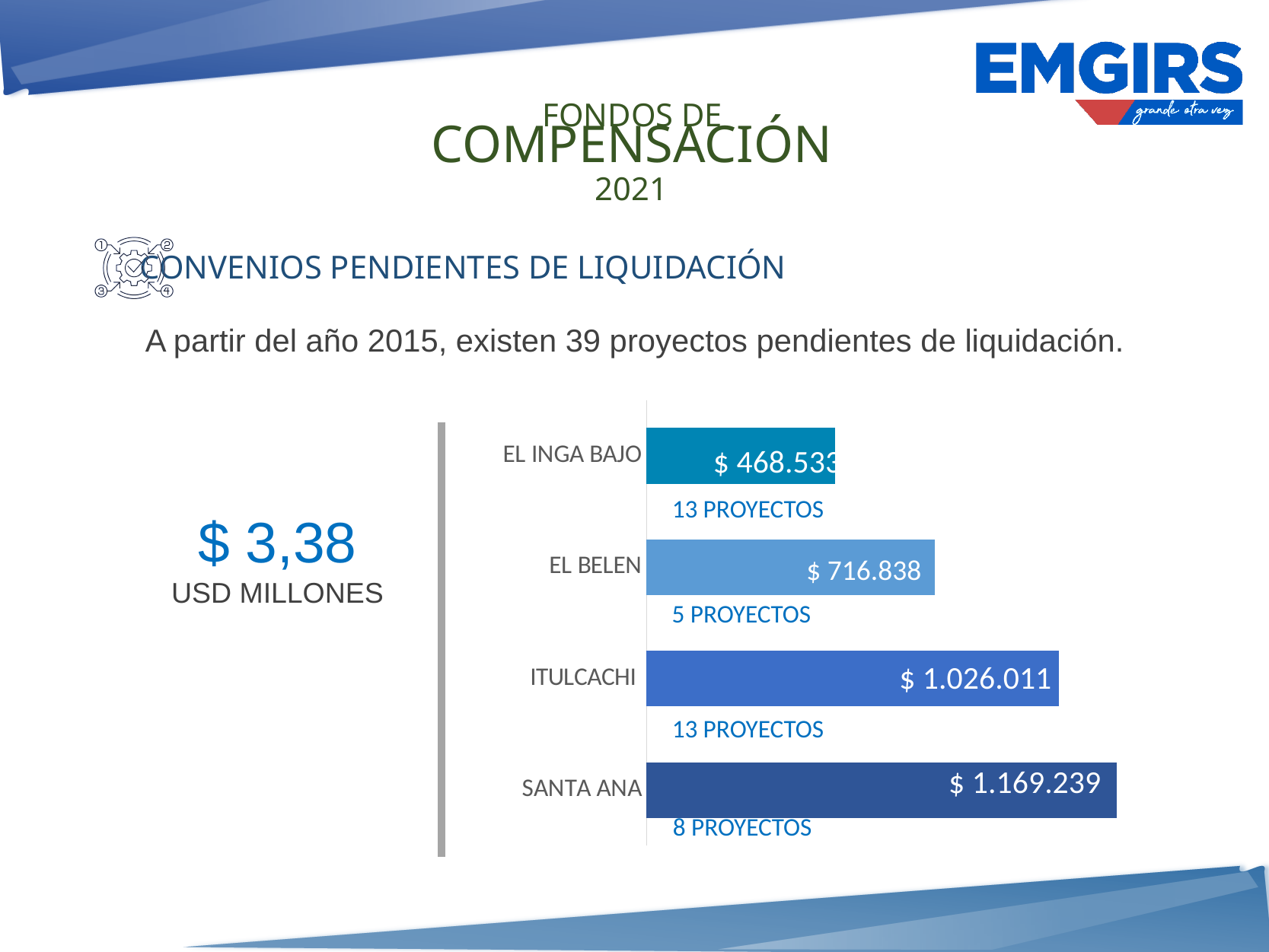
Which is larger, the value for EL BELEN or the value for ITULCACHI? ITULCACHI Which category has the highest value? SANTA ANA How many projects (PROYECTOS) are listed under EL BELEN? 5 PROYECTOS Which category has the lowest value? EL INGA BAJO What is the difference between the values for EL BELEN and EL INGA BAJO? $ 248.305 What is the value shown for SANTA ANA? $ 1.169.239 How many categories are shown in the chart? 4 What is the value shown for ITULCACHI? $ 1.026.011 What total amount in USD millions is shown to the left of the chart? $ 3,38 USD MILLONES What is the value shown for EL INGA BAJO? $ 468.533 What is the difference between the values for SANTA ANA and ITULCACHI? $ 143.228 What kind of chart is shown on the slide? bar chart